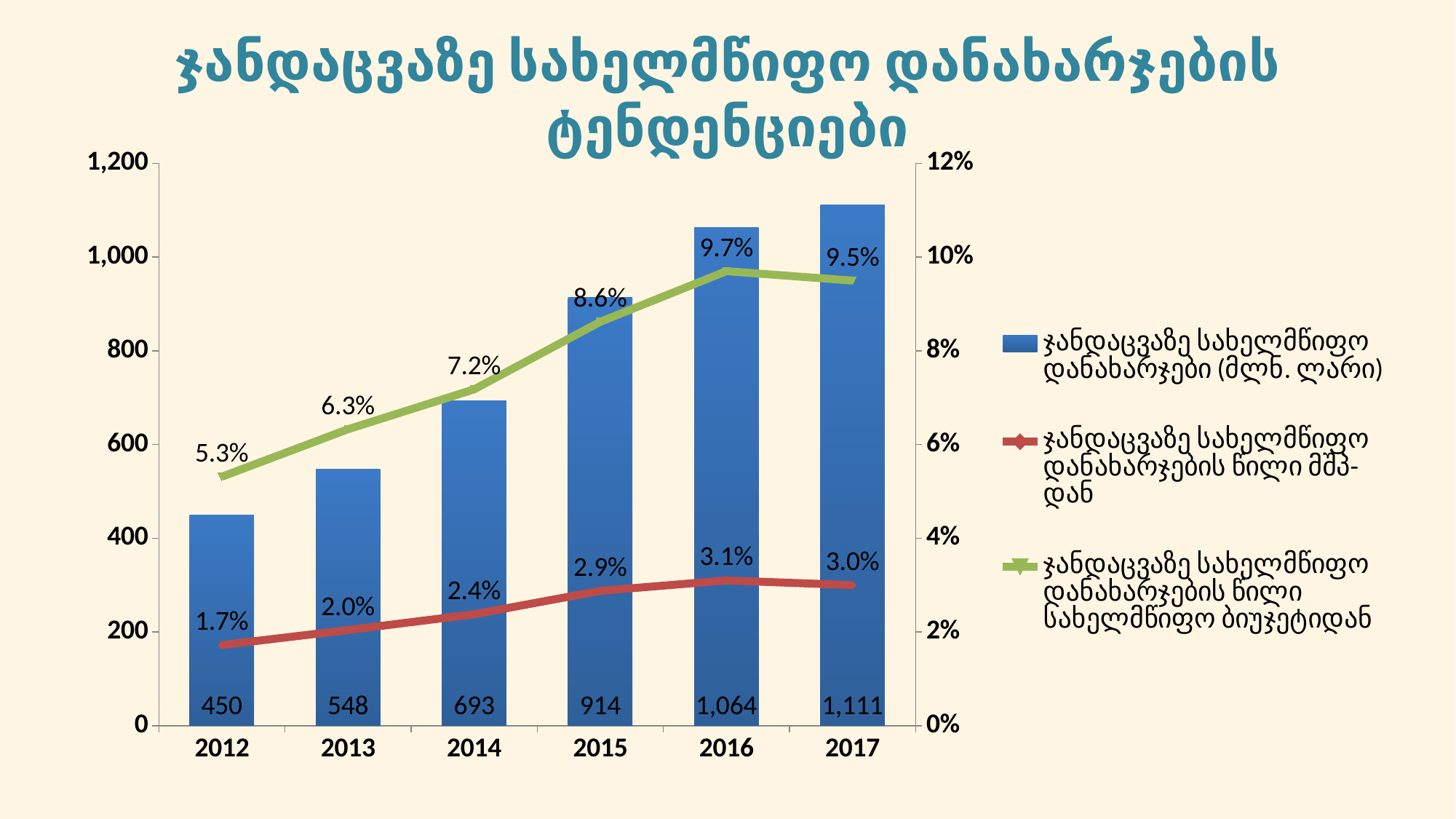
In which year is the blue bar the lowest? 2012 What is the value of the blue bar for 2014? 693 What is the value of the blue bar for 2017? 1,111 Which is larger, the red line value for 2016 or for 2017? 2016 What is the difference between the blue bar values for 2016 and 2015? 150 How many years are shown on the x axis? 6 What value does the green line show for 2013? 6.3% In which year does the green line reach its highest value? 2016 How many series does the legend list? 3 What value does the red line show for 2015? 2.9% Do the blue bar values rise or fall from 2012 to 2017? Rise What kind of chart is this? Combined bar and line chart